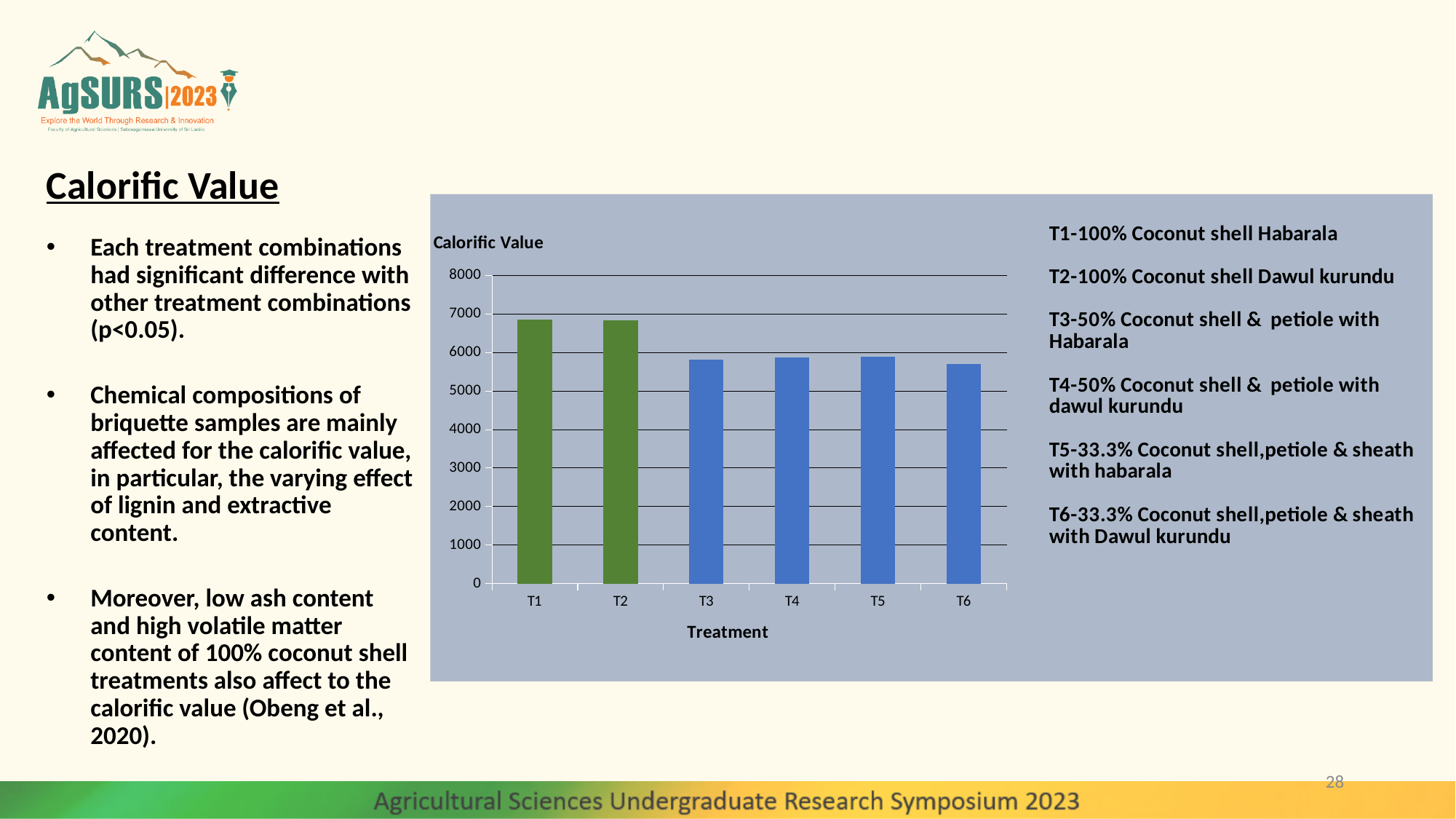
Is the value for T6 greater or less than 6000? less Is the value for T1 greater or less than 7000? less How many treatments are plotted on the x axis of the chart? 6 What is the label of the x axis of the chart? Treatment What kind of chart is shown on the slide? bar chart Is the value for T3 greater or less than 5000? greater What is the title of the chart? Calorific Value Which has the higher calorific value, T6 or T2? T2 Which has the higher calorific value, T1 or T3? T1